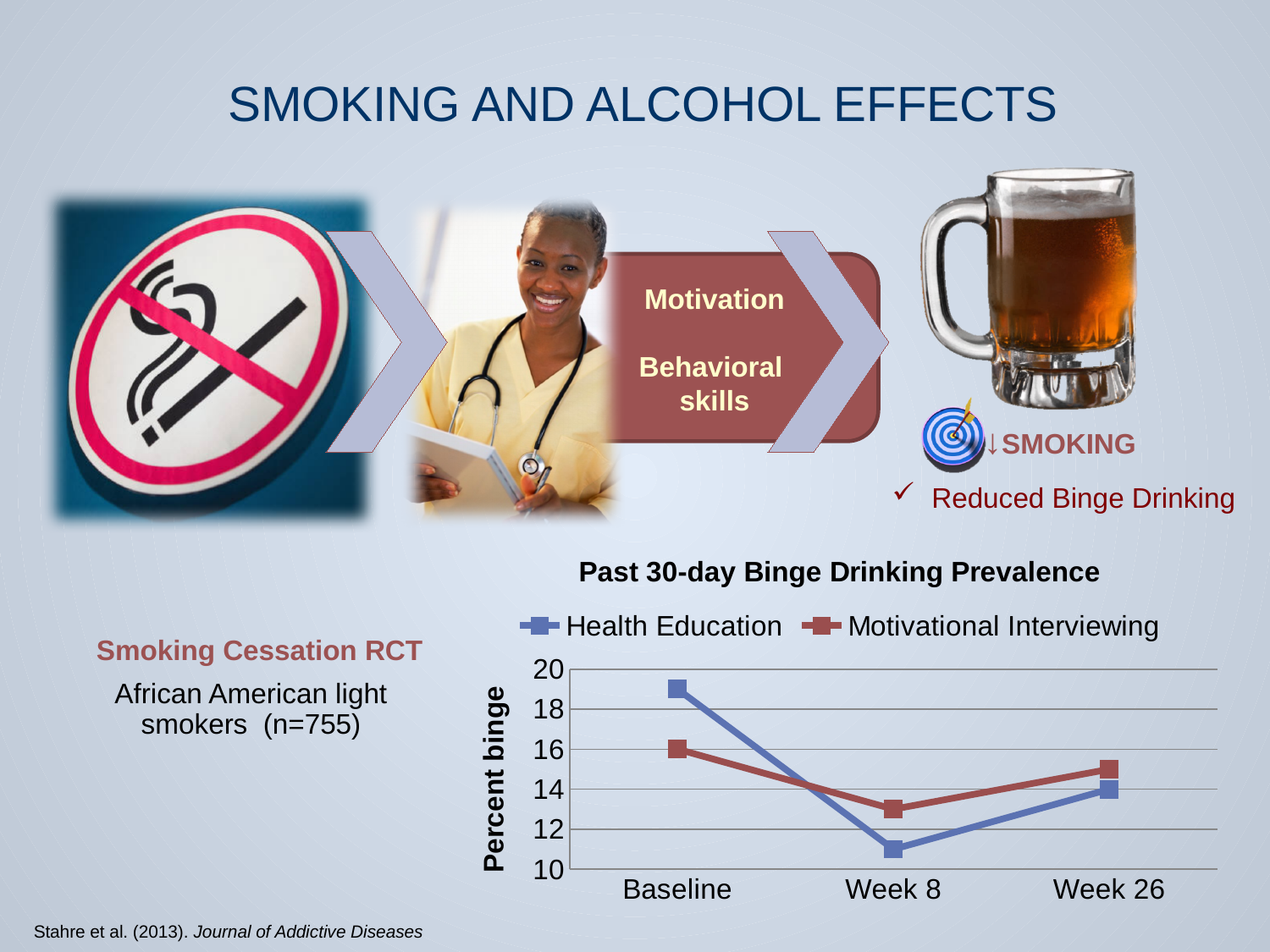
What kind of chart is shown on the slide? line chart Is the value for Health Education at Week 8 greater or less than 12? less What is the value for Motivational Interviewing at Baseline? 16 At Baseline, which series has the higher value, Health Education or Motivational Interviewing? Health Education How many time points are plotted along the x axis of the chart? 3 How many series does the legend of the chart list? 2 What is the value for Health Education at Week 26? 14 At which time point is the Health Education series lowest? Week 8 Is the value for Motivational Interviewing at Week 8 greater or less than 14? less Is the value for Health Education at Baseline greater or less than 18? greater At Week 26, which series has the higher value, Health Education or Motivational Interviewing? Motivational Interviewing Does the Health Education series rise or fall from Baseline to Week 8? fall